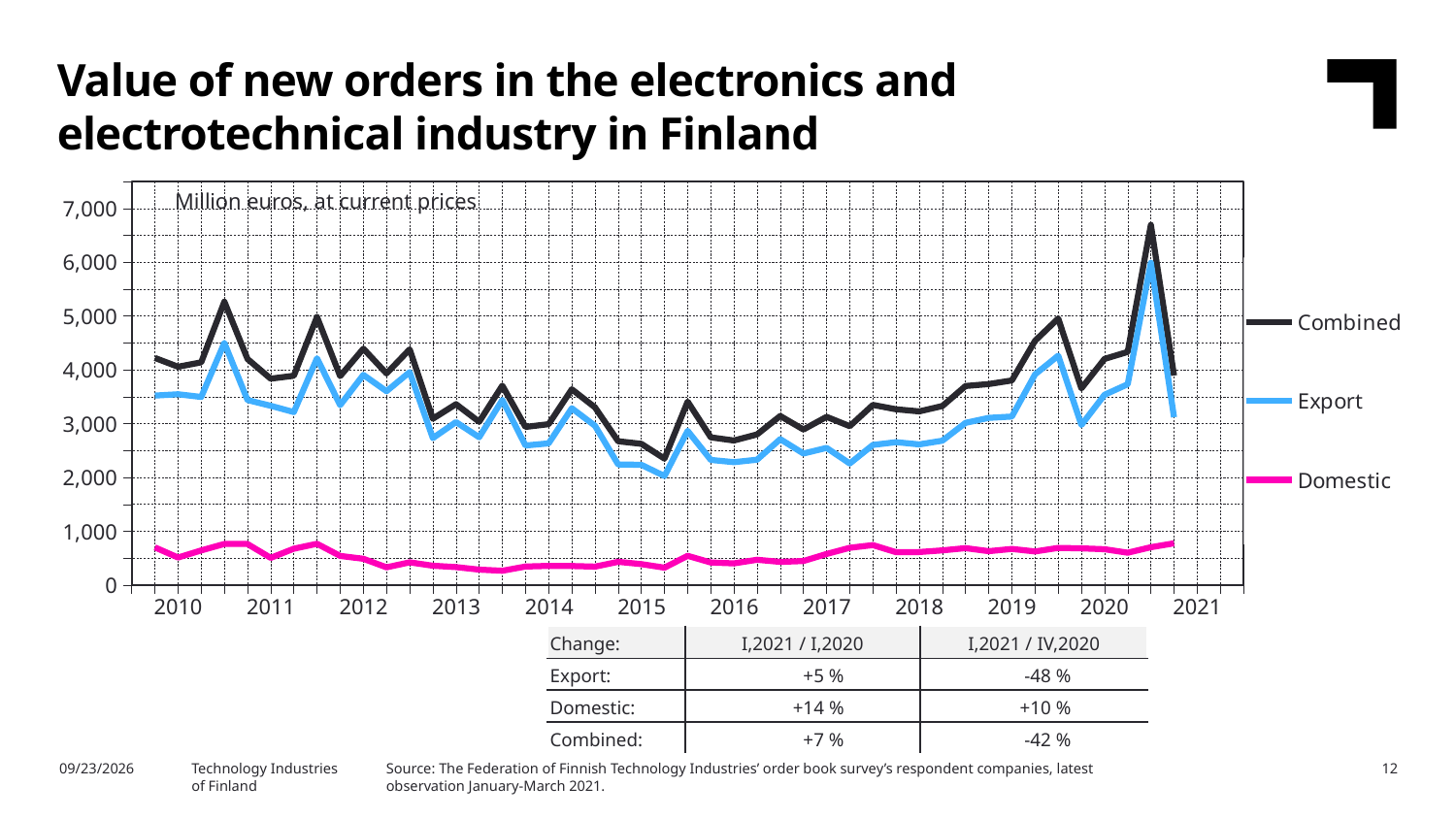
What unit is stated for the values in the chart? Million euros, at current prices How many year labels are shown on the x axis? 12 Which series are listed in the chart legend? Combined, Export, Domestic Which series has the highest values throughout the chart? Combined How many series does the legend list? 3 Which series has the lowest values throughout the chart? Domestic Is the lowest value of the Export series around 2015 greater or less than 3,000? less What kind of chart is shown on the slide? Line chart Is the peak value of the Combined series in 2020 greater or less than 6,000? greater Is the peak value of the Export series in 2020 greater or less than 5,000? greater Does the Combined series rise or fall from 2018 to its peak in 2020? rise